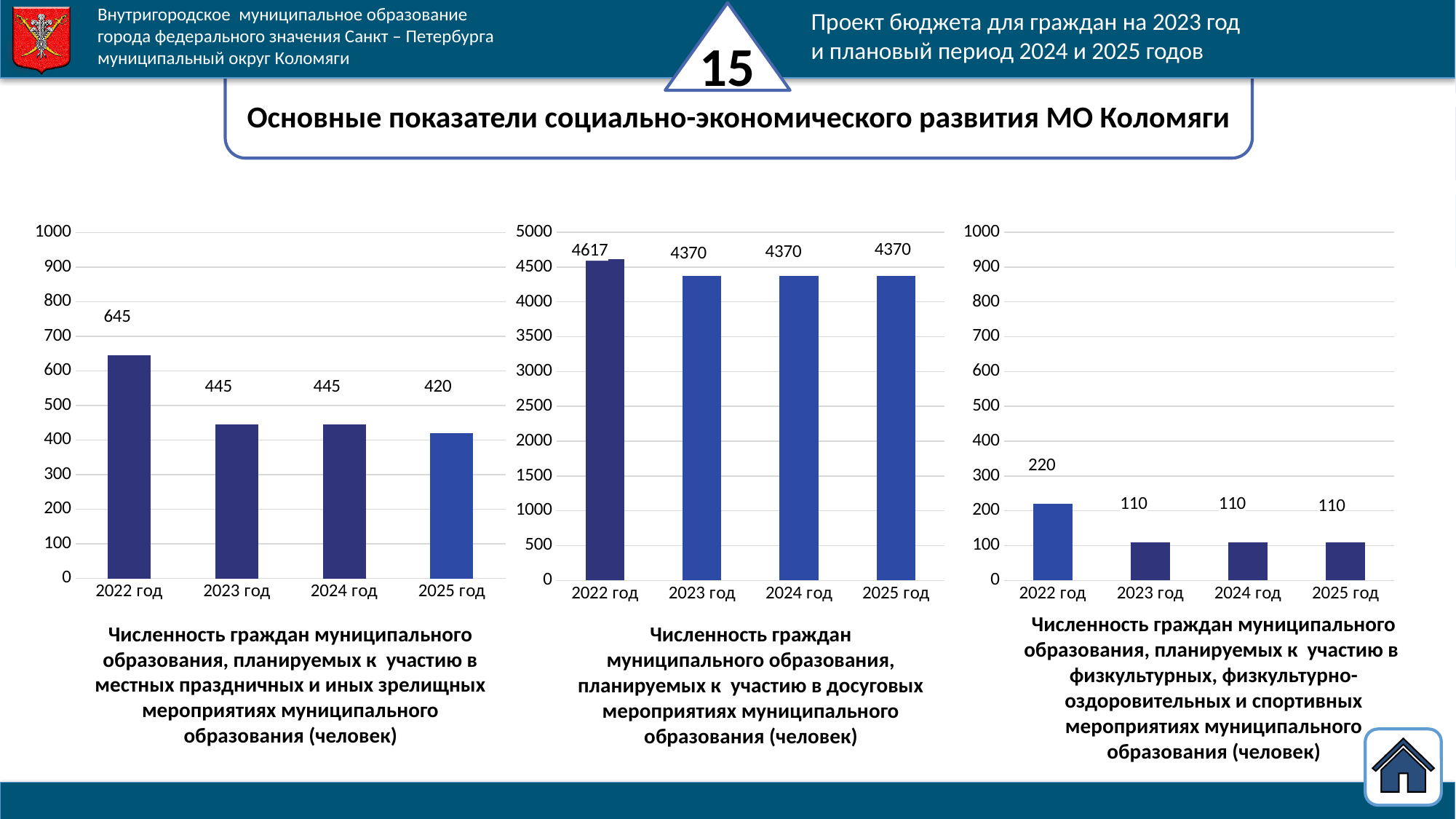
In the left chart (participants in local festive and entertainment events), which year has the highest value? 2022 год In the left chart (participants in local festive and entertainment events), what is the value for 2025 год? 420 In the left chart (participants in local festive and entertainment events), what is the value for 2022 год? 645 In the right chart (participants in physical culture and sports events), what is the value for 2022 год? 220 In the right chart (participants in physical culture and sports events), which year has the lowest value, or are several tied? 2023 год, 2024 год and 2025 год are tied at 110 In the middle chart (participants in leisure events), what is the value for 2022 год? 4617 In the middle chart (participants in leisure events), what is the difference between the values for 2022 год and 2025 год? 247 What type of chart is the left chart on the slide? bar chart In the middle chart (participants in leisure events), what is the value for 2024 год? 4370 In the right chart (participants in physical culture and sports events), is the value for 2022 год larger or smaller than the value for 2023 год? larger In the left chart (participants in local festive and entertainment events), what is the difference between the values for 2022 год and 2023 год? 200 In the middle chart (participants in leisure events), how many bars are plotted? 4